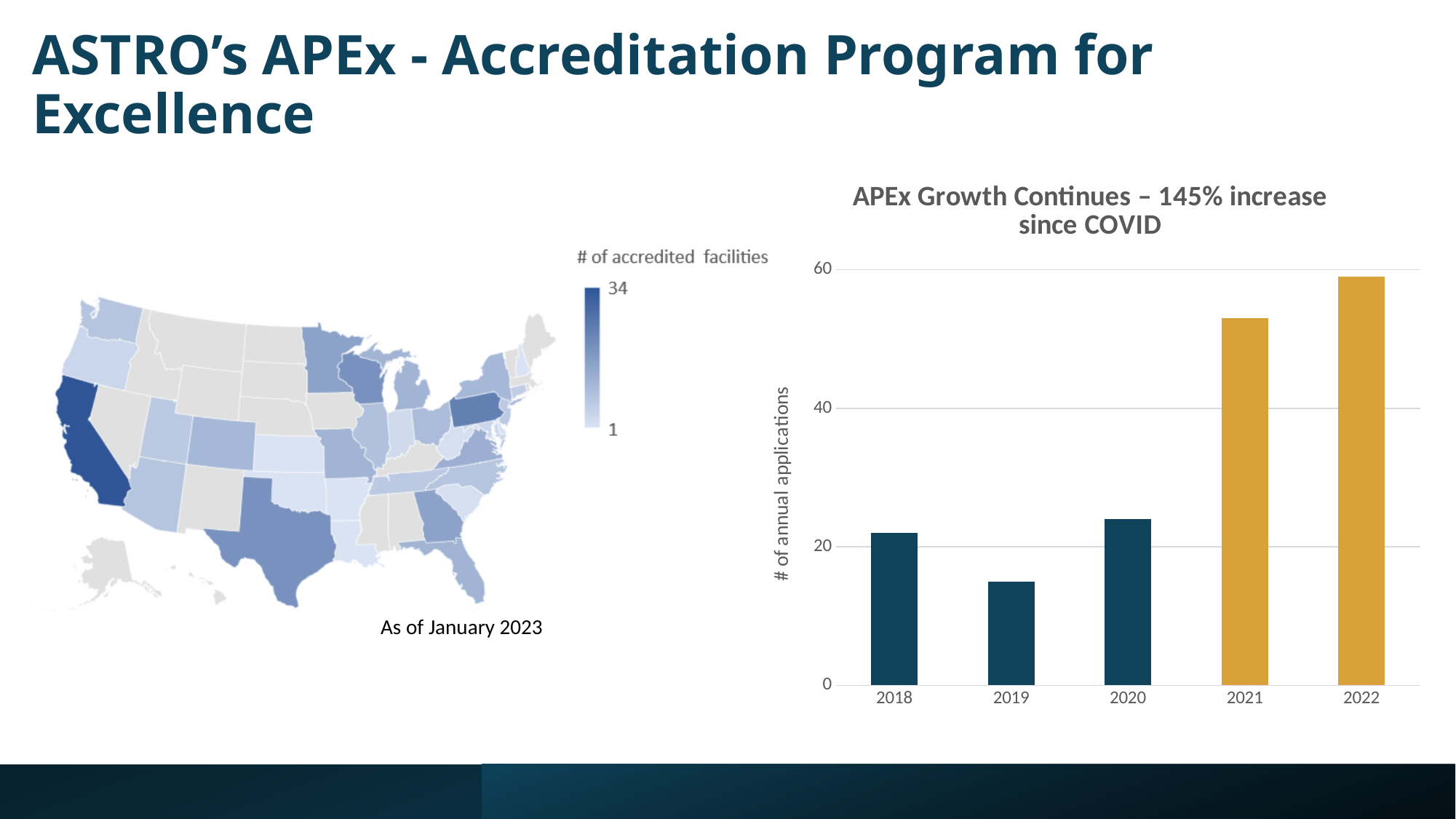
On the bar chart titled 'APEx Growth Continues', is the value for 2022 greater or less than 40? greater On the bar chart titled 'APEx Growth Continues', which year has more annual applications, 2018 or 2019? 2018 What kind of chart is the one titled 'APEx Growth Continues'? bar chart On the bar chart titled 'APEx Growth Continues', which year has the lowest number of annual applications? 2019 How many years are shown on the bar chart titled 'APEx Growth Continues'? 5 On the map on the left, what is the highest value shown on the '# of accredited facilities' legend scale? 34 On the bar chart titled 'APEx Growth Continues', is the value for 2020 greater or less than 40? less On the bar chart titled 'APEx Growth Continues', which year has more annual applications, 2020 or 2021? 2021 On the bar chart titled 'APEx Growth Continues', is the value for 2021 greater or less than 40? greater On the bar chart titled 'APEx Growth Continues', which year has the highest number of annual applications? 2022 On the bar chart titled 'APEx Growth Continues', do the values generally rise or fall from 2019 to 2022? rise